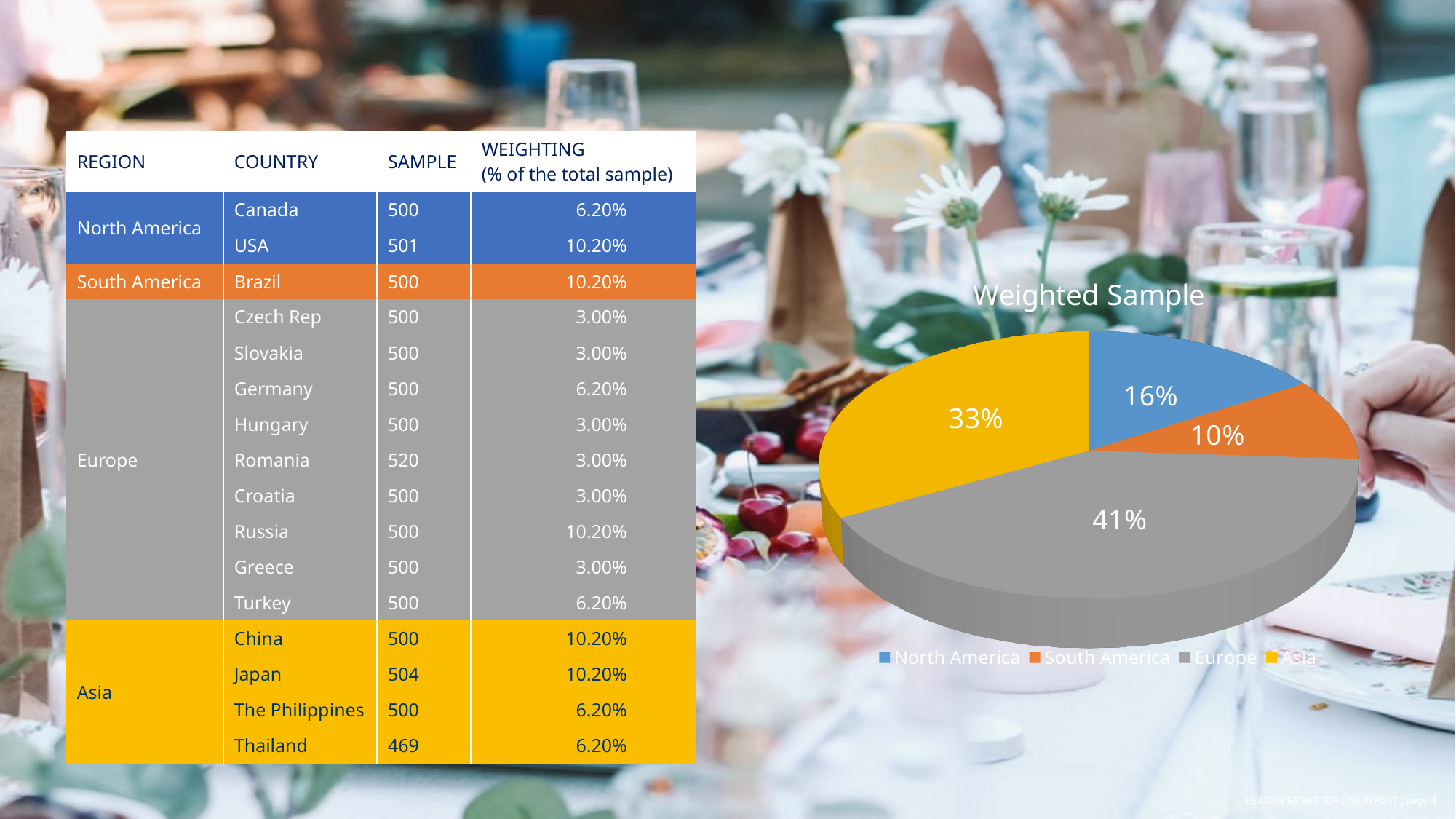
What share of the weighted sample does South America account for? 10% What is the title of the chart? Weighted Sample What share of the weighted sample does Europe account for? 41% How many regions are shown in the pie chart? 4 What type of chart is shown on the slide? pie chart How many entries does the legend list? 4 Which region has the largest slice of the pie? Europe Which region has the smallest slice of the pie? South America What share of the weighted sample does Asia account for? 33% What share of the weighted sample does North America account for? 16% What is the difference in percentage points between the Europe slice and the Asia slice? 8 Which slice is larger, North America or South America? North America